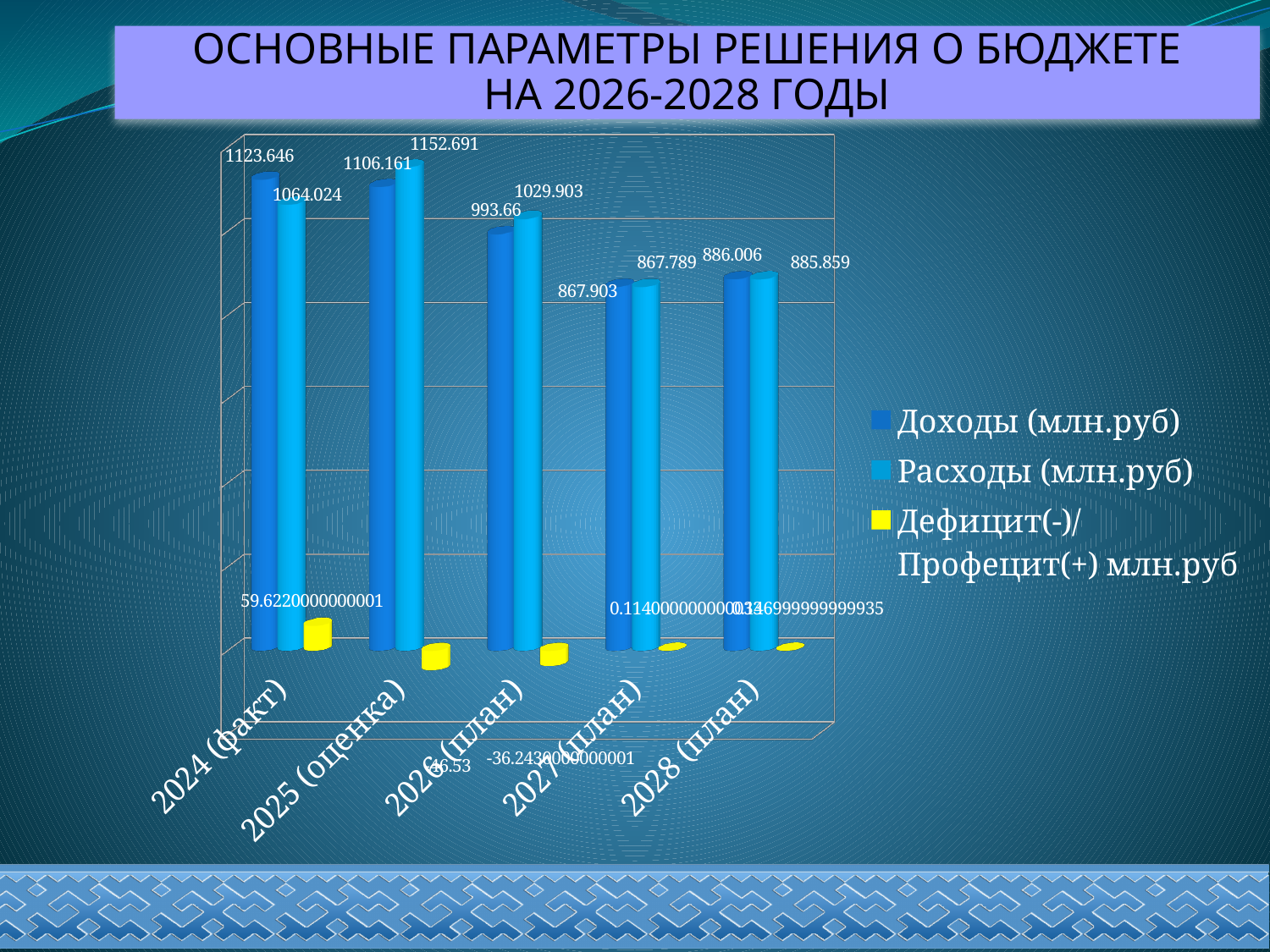
What is the value of Расходы (млн.руб) for 2025 (оценка)? 1152.691 How many series does the legend list? 3 In 2026 (план), which is larger: Доходы or Расходы? Расходы In which year is Расходы (млн.руб) the highest? 2025 (оценка) How many year categories are shown on the x axis? 5 What type of chart is shown on the slide? Bar chart What is the value of Доходы (млн.руб) for 2026 (план)? 993.66 In which year is Доходы (млн.руб) the lowest? 2027 (план) What is the value of Расходы (млн.руб) for 2028 (план)? 885.859 What is the value of Дефицит(-)/Профецит(+) for 2024 (факт)? 59.6220000000001 What is the value of Доходы (млн.руб) for 2024 (факт)? 1123.646 By how much does Расходы exceed Доходы in 2025 (оценка)? 46.53